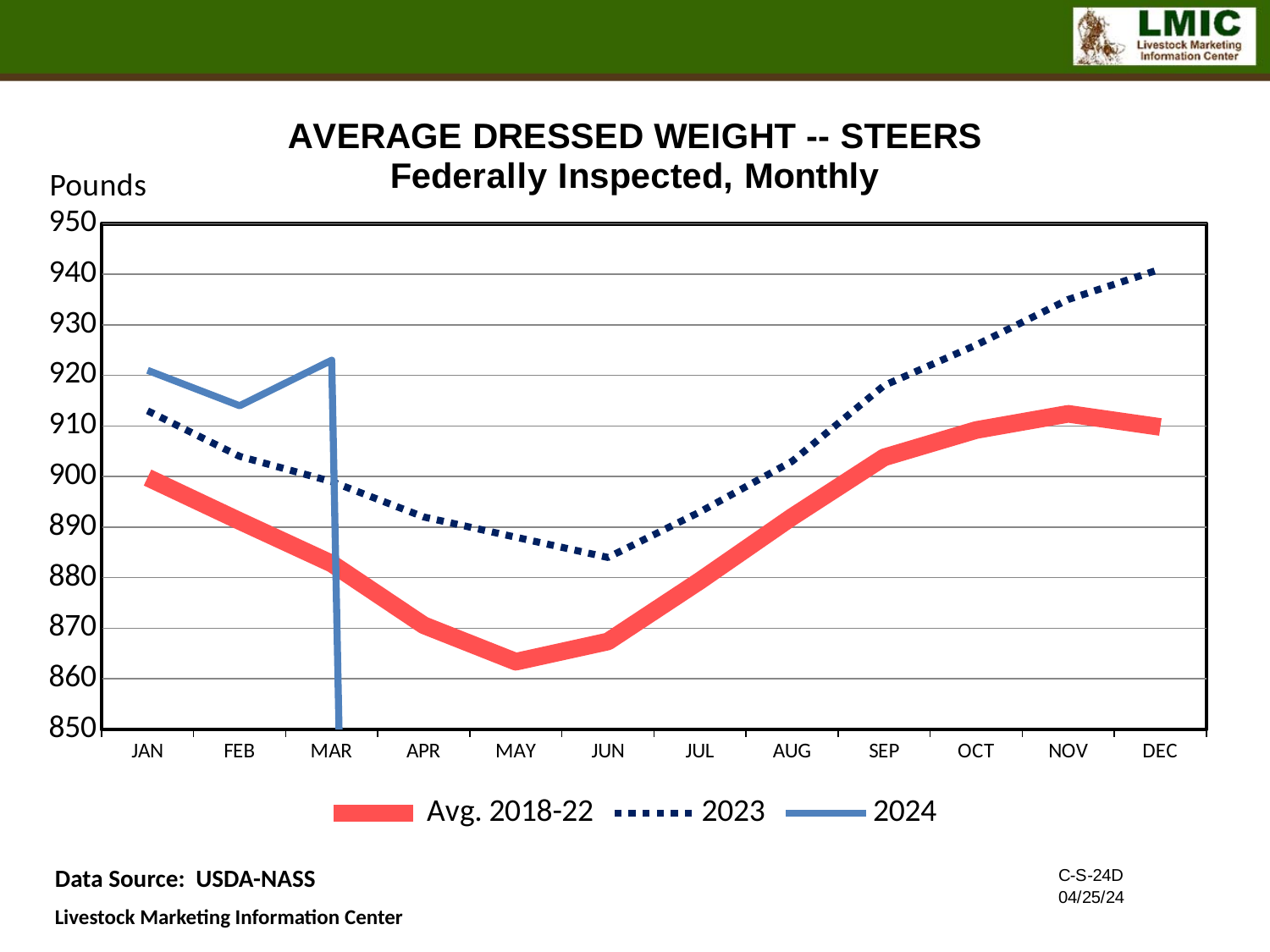
Is the 2024 value for JAN greater or less than 910? greater In JAN, which series has the higher value: 2023 or Avg. 2018-22? 2023 In which month does the 2023 series reach its highest value? DEC Does the 2023 series rise or fall from JUN to DEC? rise In which month does the 2023 series reach its lowest value? JUN What kind of chart is shown on the slide? line chart In which month does the Avg. 2018-22 series reach its lowest value? MAY How many months are shown on the x axis? 12 What unit is labelled on the y axis? Pounds How many series does the legend list? 3 Is the 2023 value for DEC greater or less than 930? greater Is the Avg. 2018-22 value for MAY greater or less than 870? less